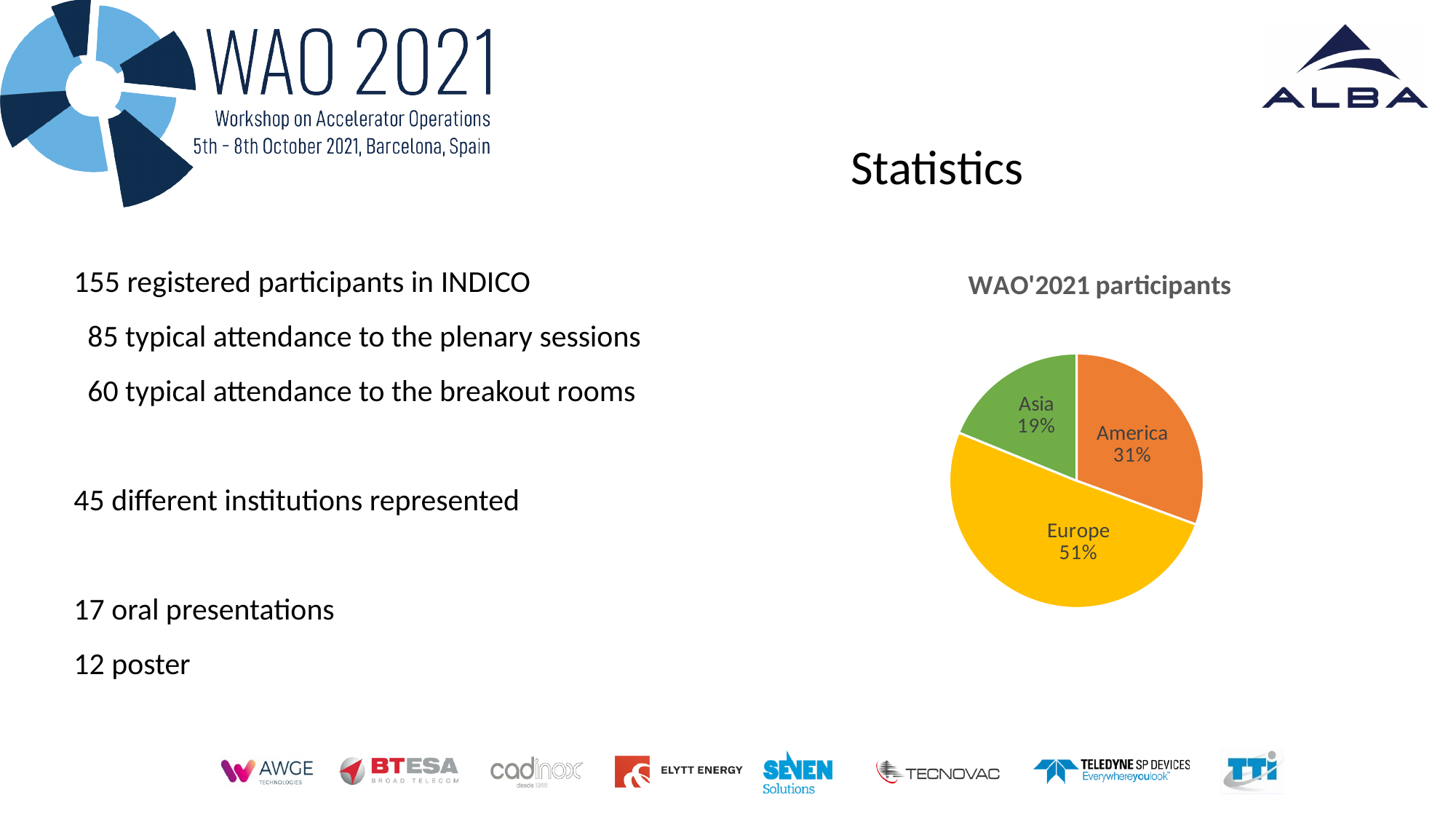
How many regions are shown in the pie chart? 3 What share of WAO'2021 participants came from Europe? 51% What colour is the Europe slice of the pie chart? Yellow How many percentage points larger is Europe's share than America's share of participants? 20 Which region has a larger share of participants, America or Asia? America Which region has the smallest share of WAO'2021 participants? Asia What is the title of the chart? WAO'2021 participants Which region has the largest share of WAO'2021 participants? Europe What share of WAO'2021 participants came from America? 31% What kind of chart is used to show the WAO'2021 participants? Pie chart How many percentage points larger is America's share than Asia's share of participants? 12 What share of WAO'2021 participants came from Asia? 19%